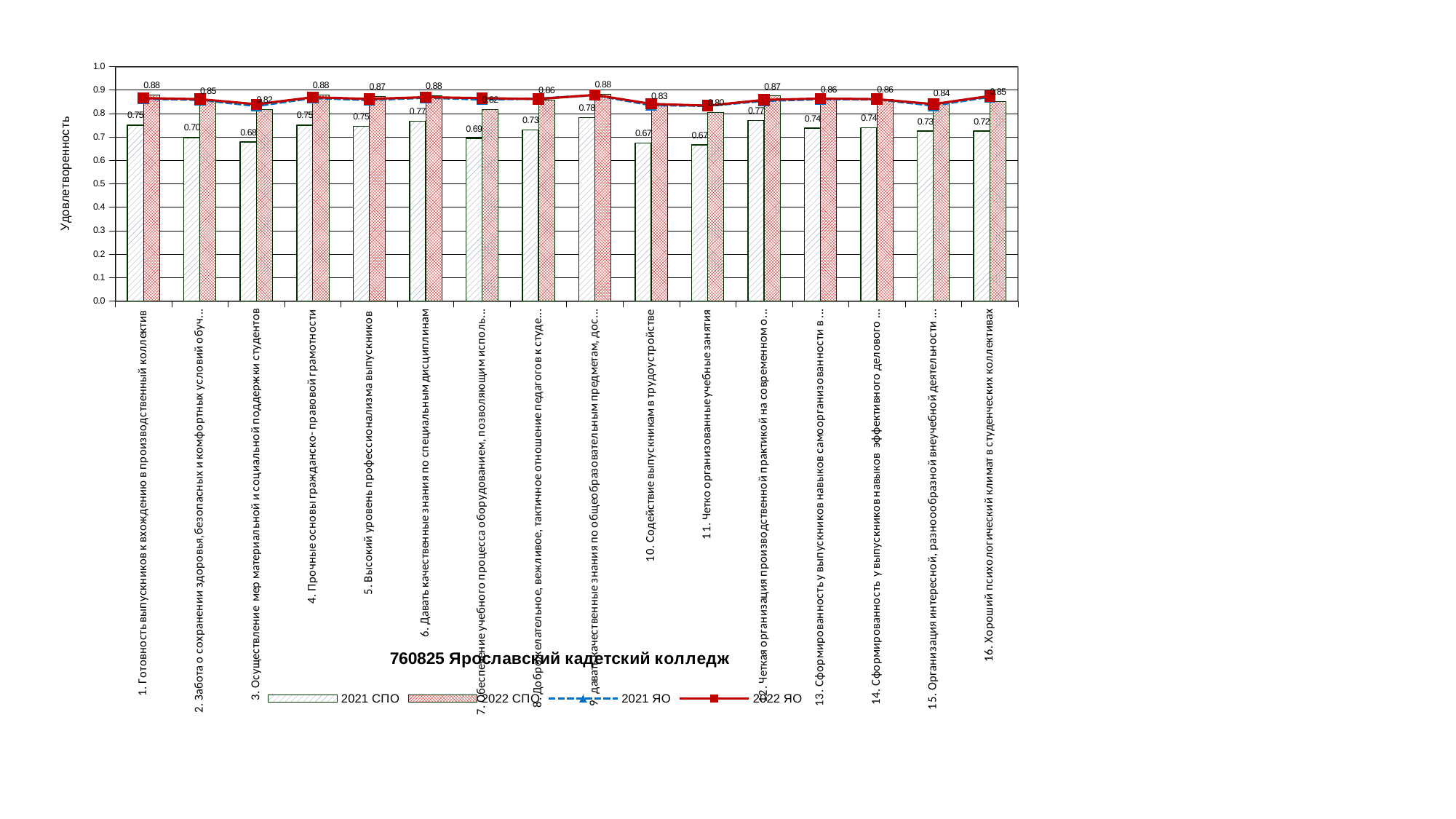
How many categories are plotted along the x axis? 16 What kind of chart is shown on the slide? Combined bar and line chart Which category has the highest 2021 СПО value? 9. Давать качественные знания по общеобразовательным предметам What is the 2021 СПО value for "3. Осуществление мер материальной и социальной поддержки студентов"? 0.68 What is the difference between the 2021 СПО values for category 16 (Хороший психологический климат) and category 3 (Осуществление мер материальной и социальной поддержки)? 0.04 What is the 2021 СПО value for "10. Содействие выпускникам в трудоустройстве"? 0.67 What is the 2021 СПО value for "4. Прочные основы гражданско-правовой грамотности"? 0.75 What is the 2021 СПО value for "16. Хороший психологический климат в студенческих коллективах"? 0.72 How many series does the legend list? 4 What is the label of the vertical axis? Удовлетворенность What is the title of the chart? 760825 Ярославский кадетский колледж Is the 2022 СПО value for "1. Готовность выпускников к вхождению в производственный коллектив" greater or less than 0.8? greater